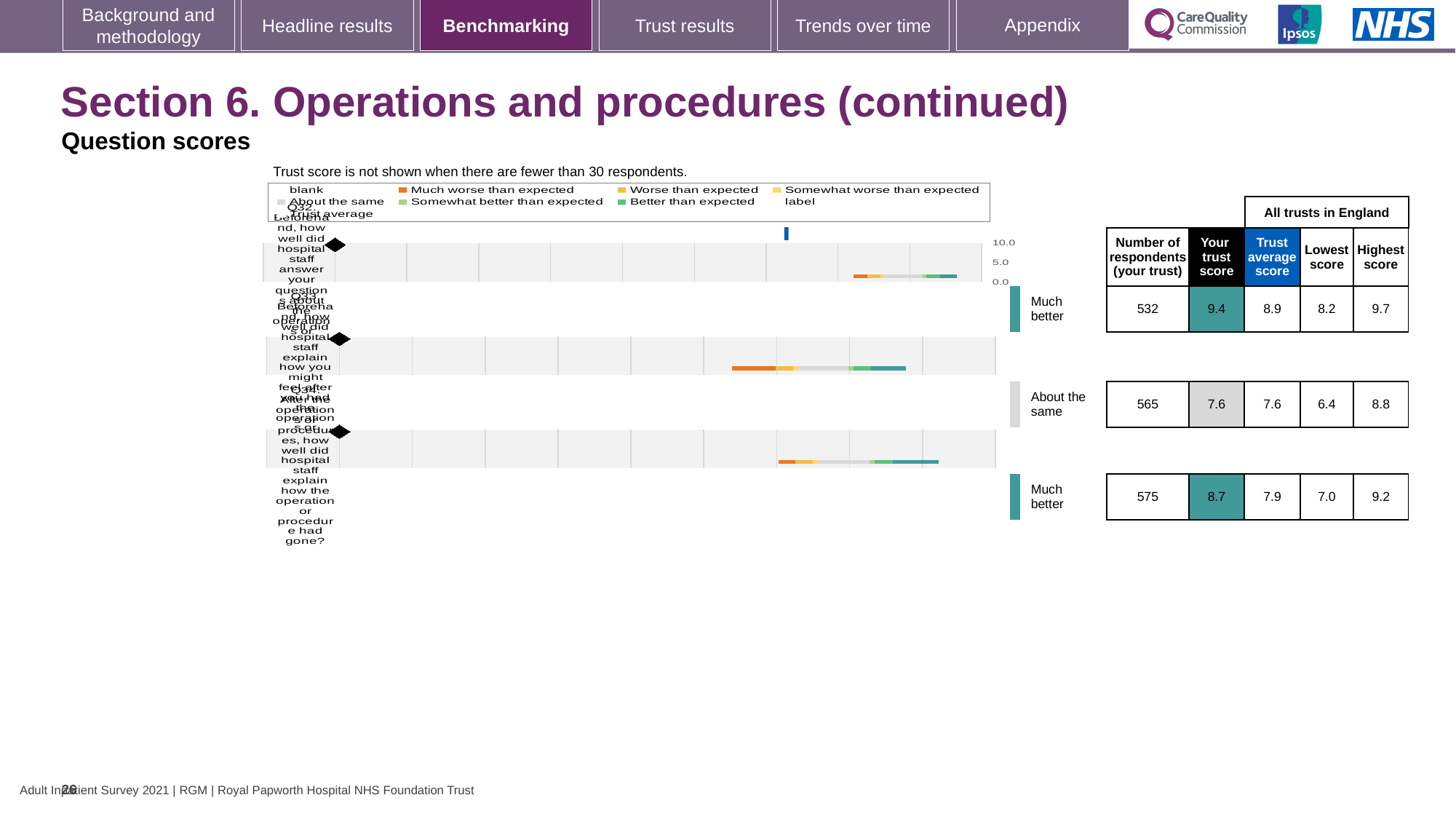
How many respondents does the table show for the second question row (Q33)? 565 What is the 'Your trust score' for the first question row (Q32, about hospital staff answering questions before the operation)? 9.4 How many question rows are shown in the benchmarking chart? 3 Which question row has the highest 'Your trust score'? The first row (Q32), 9.4 Which question row has the lowest 'Lowest score' value? The second row (Q33), 6.4 For the third question row (Q34), which is larger: 'Your trust score' or the 'Trust average score'? Your trust score (8.7) For the first question row (Q32), what is the difference between 'Your trust score' and the 'Trust average score'? 0.5 What benchmark category label is shown for the second question row (Q33)? About the same What is the 'Trust average score' for the third question row (Q34)? 7.9 How many more respondents are there for the third question row (Q34) than for the first question row (Q32)? 43 What is the 'Highest score' across all trusts in England for the third question row (Q34)? 9.2 What colour does the legend use for 'Much worse than expected'? Orange